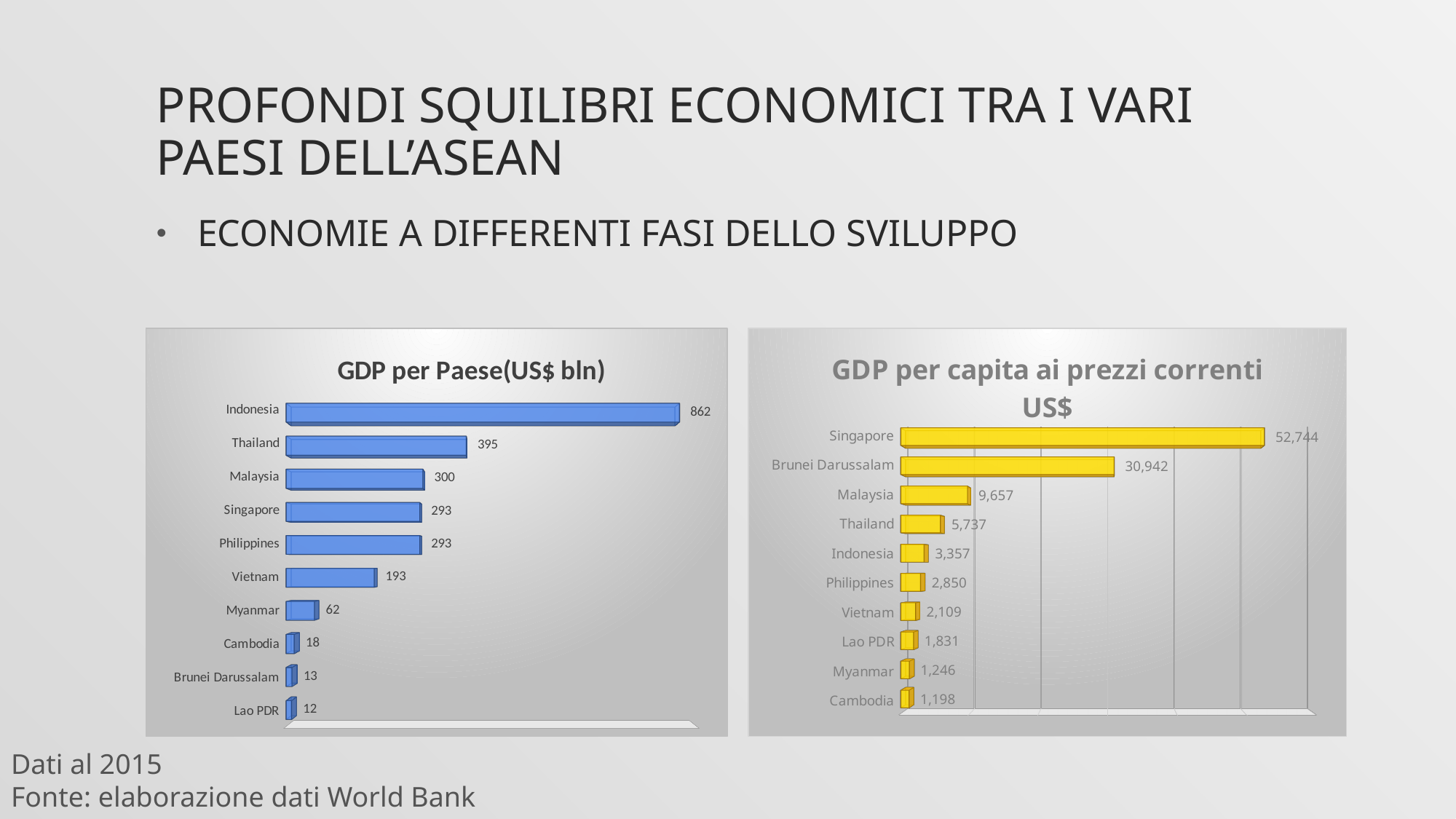
In the 'GDP per Paese(US$ bln)' chart, what is the value for Thailand? 395 In the 'GDP per Paese(US$ bln)' chart, what is the difference between Indonesia and Thailand? 467 In the 'GDP per Paese(US$ bln)' chart, which country has the lowest GDP? Lao PDR In the 'GDP per capita ai prezzi correnti US$' chart, what is the difference between Singapore and Brunei Darussalam? 21,802 In the 'GDP per Paese(US$ bln)' chart, which country has the highest GDP? Indonesia What colour are the bars in the 'GDP per capita ai prezzi correnti US$' chart? Yellow In the 'GDP per capita ai prezzi correnti US$' chart, which country has the lowest GDP per capita? Cambodia In the 'GDP per capita ai prezzi correnti US$' chart, which is larger, Vietnam or Lao PDR? Vietnam In the 'GDP per Paese(US$ bln)' chart, how many countries are shown? 10 In the 'GDP per capita ai prezzi correnti US$' chart, which country has the highest GDP per capita? Singapore In the 'GDP per capita ai prezzi correnti US$' chart, what is the value for Malaysia? 9,657 What type of chart is the 'GDP per Paese(US$ bln)' chart? Bar chart